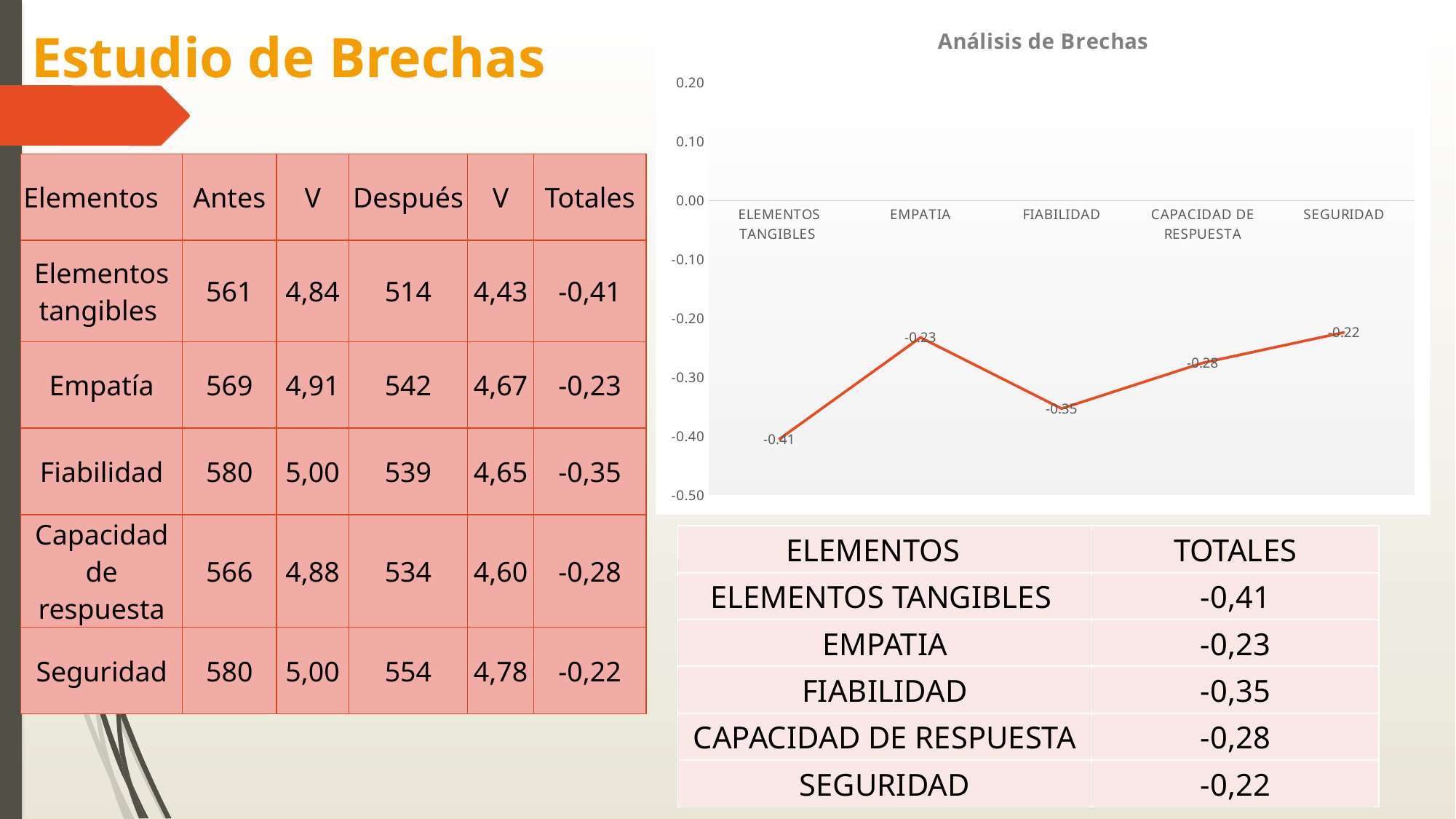
Is the value for ELEMENTOS TANGIBLES greater or less than -0.30? less What is the title of the chart? Análisis de Brechas What is the value for ELEMENTOS TANGIBLES on the chart? -0.41 How many categories are plotted on the chart? 5 Which is larger, the value for CAPACIDAD DE RESPUESTA or the value for FIABILIDAD? CAPACIDAD DE RESPUESTA Which category has the lowest value on the chart? ELEMENTOS TANGIBLES What is the value for FIABILIDAD on the chart? -0.35 What is the difference between the values for EMPATIA and FIABILIDAD? 0.12 What is the value for CAPACIDAD DE RESPUESTA on the chart? -0.28 What type of chart is shown on the slide? line chart What is the value for EMPATIA on the chart? -0.23 Which category has the highest value on the chart? SEGURIDAD